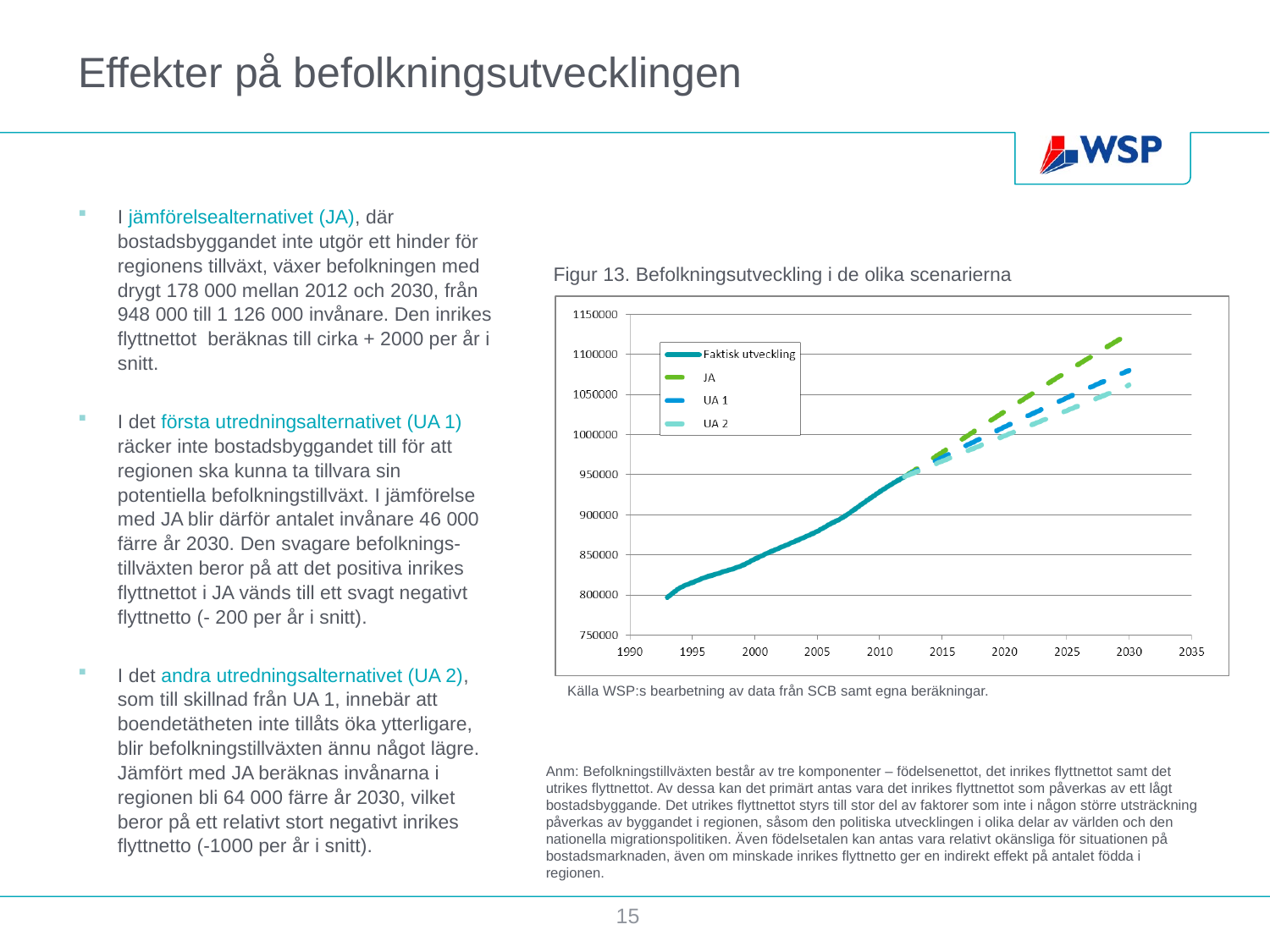
Is the value of the JA line in 2030 greater or less than 1100000? greater Which scenario line reaches the highest value by 2030? JA What kind of chart is shown in Figur 13? Line chart Does the Faktisk utveckling line rise or fall from 1990 to 2012? Rises Is the value of the Faktisk utveckling line in 2005 greater or less than 900000? less Which scenario line is lowest by 2030? UA 2 What are the series names listed in the chart legend? Faktisk utveckling, JA, UA 1, UA 2 In 2030, which is larger, the JA line or the UA 2 line? JA What is the title of the chart on the slide? Figur 13. Befolkningsutveckling i de olika scenarierna How many series does the legend of the chart list? 4 Is the value of the UA 1 line in 2030 greater or less than 1100000? less